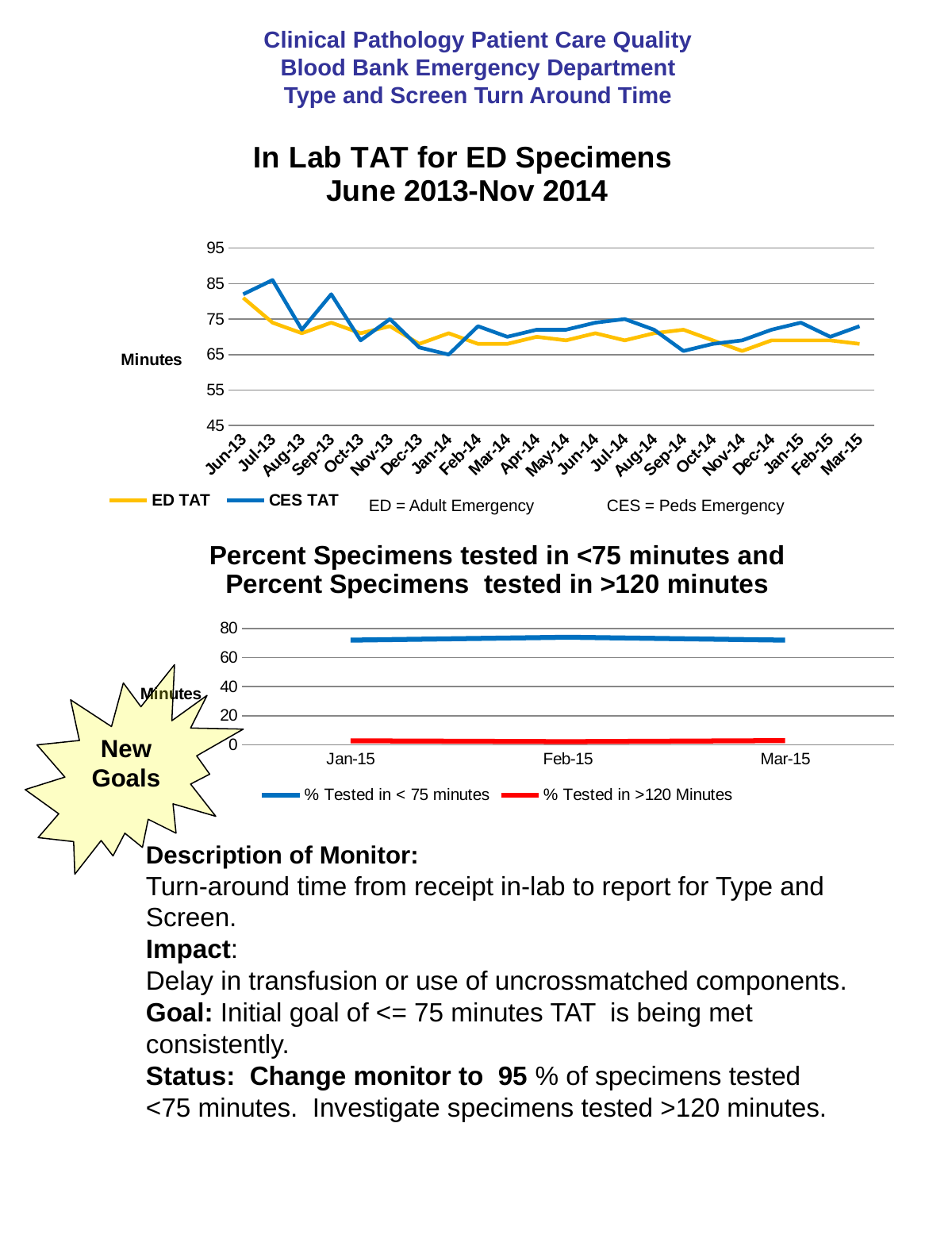
In the 'In Lab TAT for ED Specimens' chart, does the ED TAT line overall rise or fall from Jun-13 to Mar-15? fall In the 'In Lab TAT for ED Specimens' chart, which series has the higher value in Jul-13, ED TAT or CES TAT? CES TAT In the 'Percent Specimens tested in <75 minutes and Percent Specimens tested in >120 minutes' chart, is the '% Tested in < 75 minutes' value for Jan-15 greater or less than 60? greater What kind of chart is the 'In Lab TAT for ED Specimens' chart? line chart How many series does the legend of the 'In Lab TAT for ED Specimens' chart list? 2 In the 'Percent Specimens tested in <75 minutes and Percent Specimens tested in >120 minutes' chart, which series has the larger value in Mar-15? % Tested in < 75 minutes What does the legend of the 'In Lab TAT for ED Specimens' chart say the blue line represents? CES TAT In the 'In Lab TAT for ED Specimens' chart, is the CES TAT value for Jan-14 greater or less than 75? less How many months are plotted along the x axis of the 'In Lab TAT for ED Specimens' chart? 22 In the 'In Lab TAT for ED Specimens' chart, which month has the highest CES TAT value? Jul-13 In the 'In Lab TAT for ED Specimens' chart, is the ED TAT value for Jun-13 greater or less than 75? greater How many months are plotted on the x axis of the 'Percent Specimens tested in <75 minutes and Percent Specimens tested in >120 minutes' chart? 3